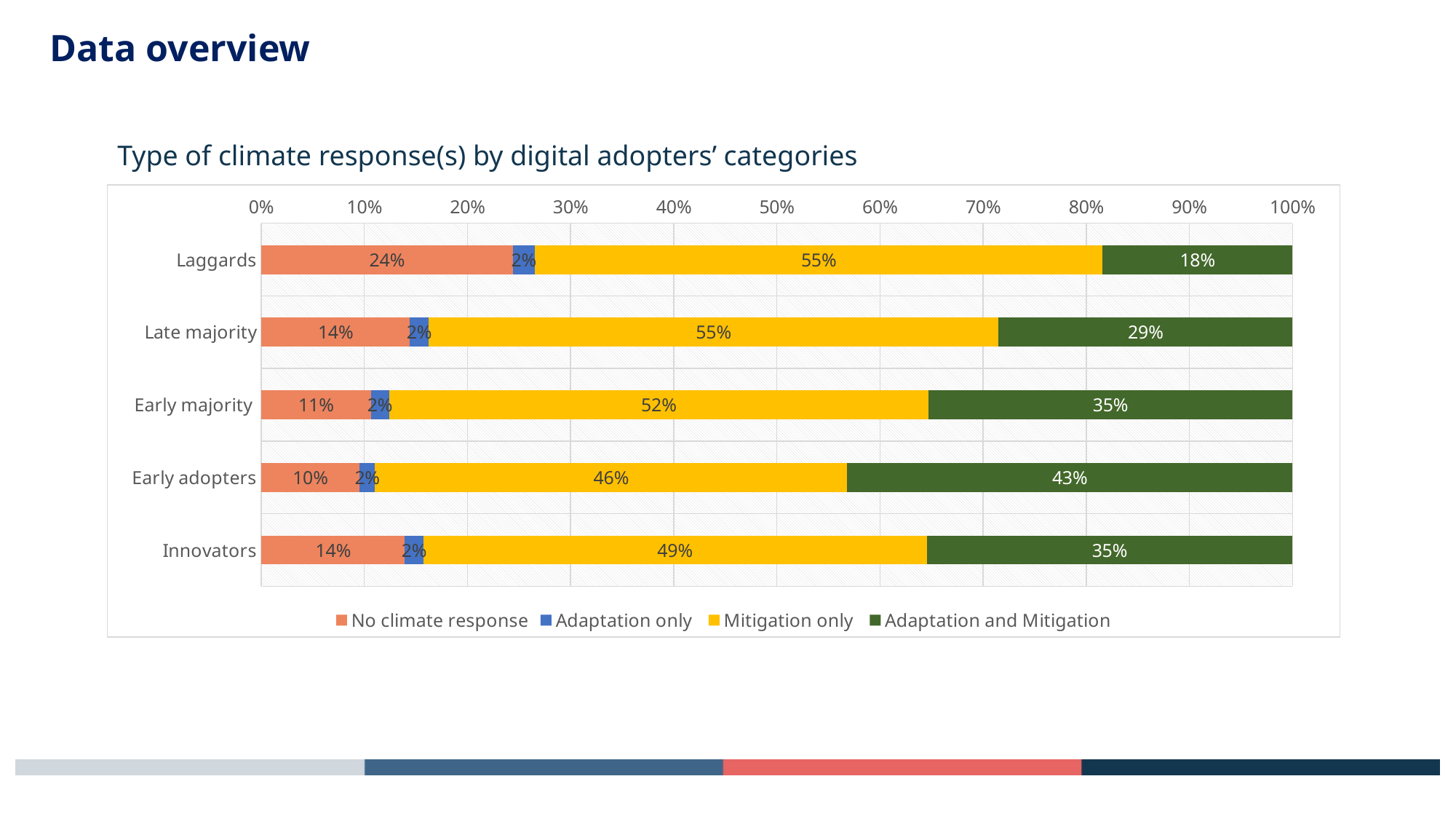
What is the Adaptation and Mitigation value for Early adopters? 43% Which category has the highest No climate response share? Laggards What is the difference between the Adaptation and Mitigation values for Early adopters and Laggards? 25% What is the Mitigation only value for Innovators? 49% How many series does the legend list? 4 Which category has the highest Adaptation and Mitigation share? Early adopters Which category has the lowest Adaptation and Mitigation share? Laggards What percentage of Laggards have no climate response? 24% What kind of chart is shown on the slide? Stacked bar chart How many digital adopter categories are shown on the chart? 5 What is the title of the chart? Type of climate response(s) by digital adopters' categories Is the Mitigation only value larger for Laggards or for Early adopters? Laggards